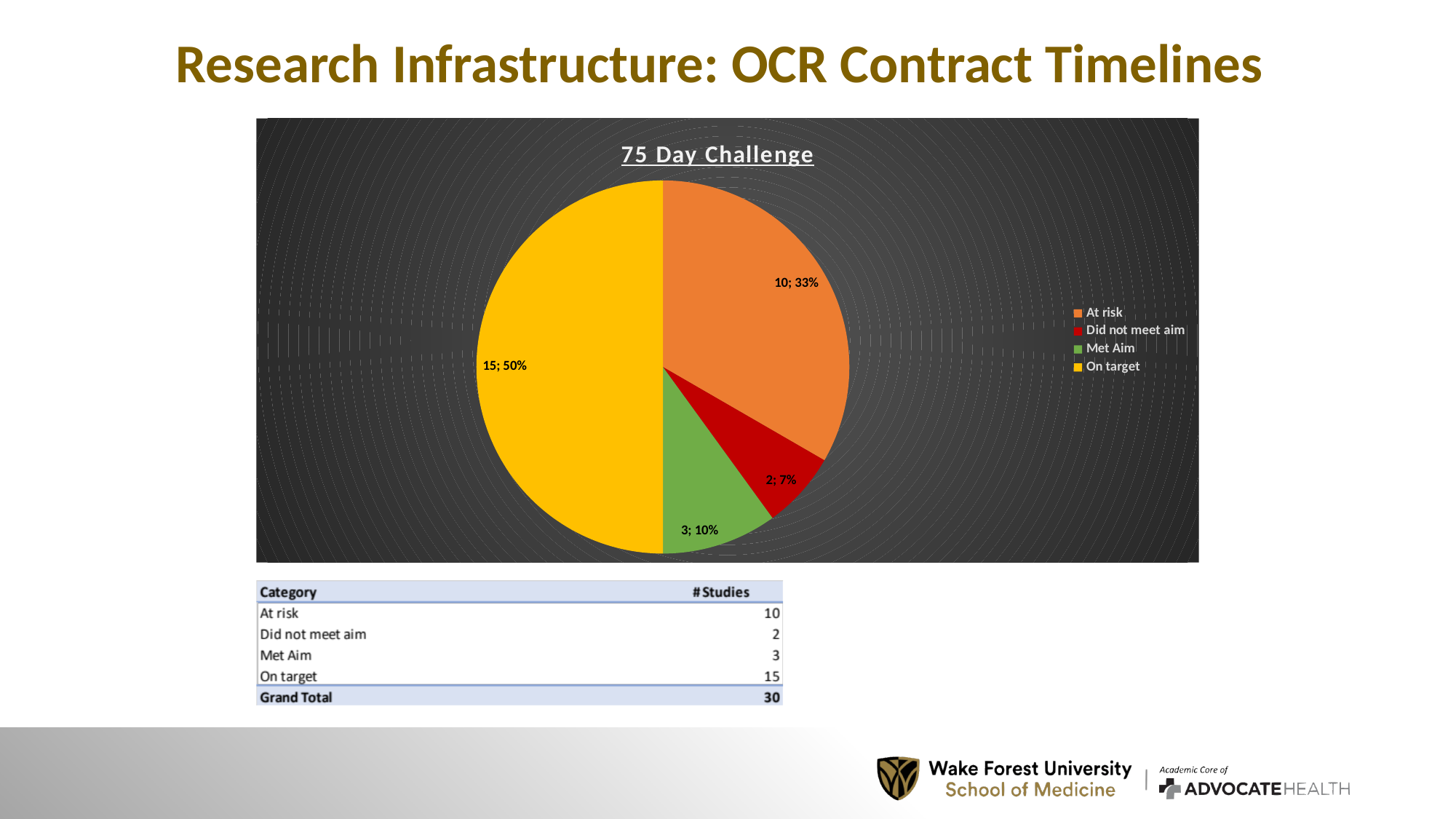
How many entries does the legend list? 4 How many slices does the pie chart have? 4 How many studies are in the 'On target' category? 15 What is the difference in number of studies between 'On target' and 'At risk'? 5 What percentage share of the pie does 'Did not meet aim' represent? 7% Which colour represents 'Did not meet aim' in the pie chart? red What is the title of the chart? 75 Day Challenge Which category has the largest slice of the pie? On target What type of chart is shown on the slide? pie chart How many studies are in the 'At risk' category? 10 What percentage share of the pie does 'Met Aim' represent? 10% Which category has the smallest slice of the pie? Did not meet aim